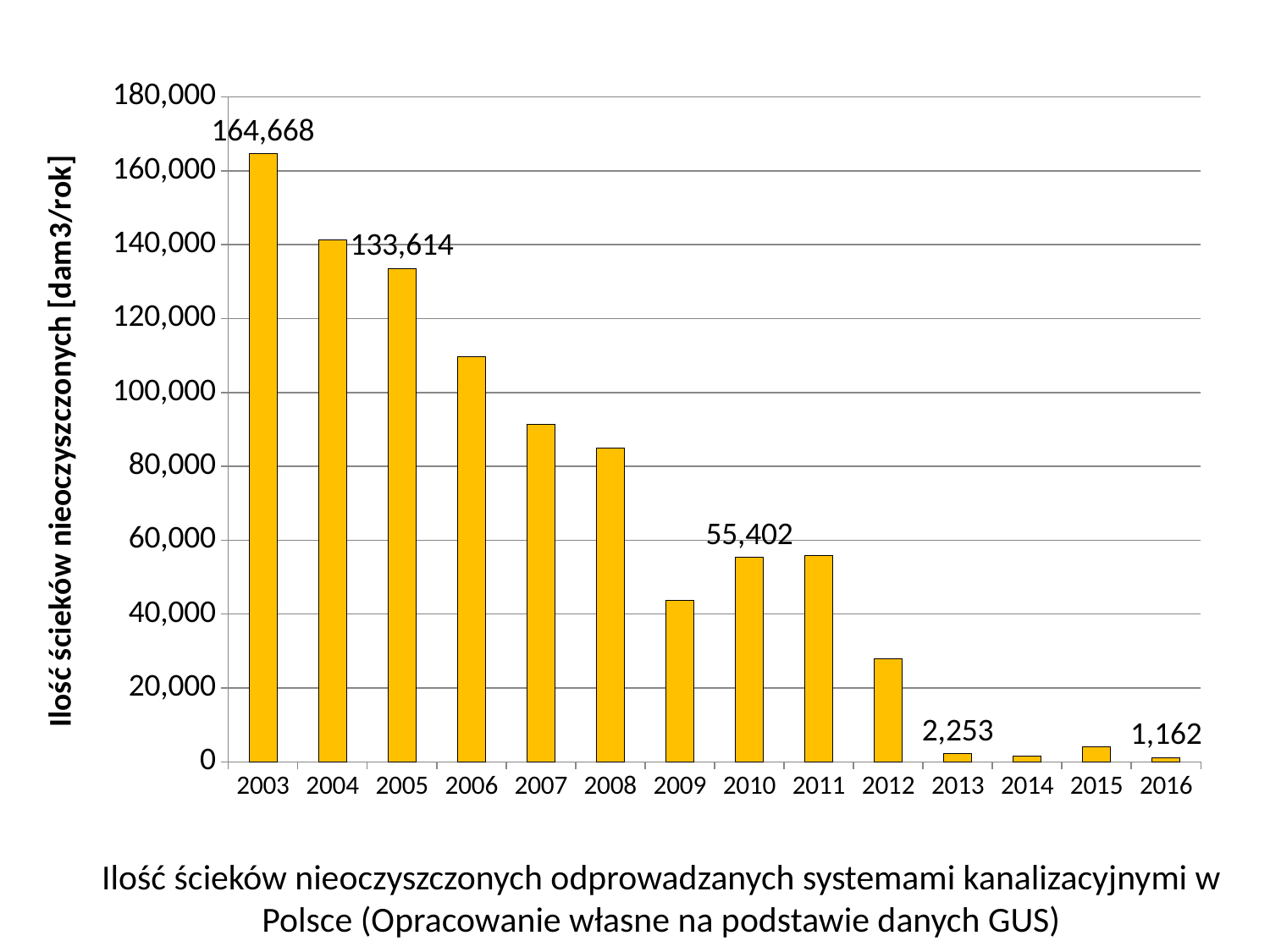
Is the value for 2006 greater or less than 100,000? greater What is the value for 2016? 1,162 What is the difference between the values for 2003 and 2005? 31,054 What is the difference between the values for 2013 and 2016? 1,091 How many years (bars) are shown on the x axis? 14 What is the value for 2010? 55,402 Which year has the highest value? 2003 What type of chart is shown on the slide? Bar chart Is the value for 2012 greater or less than 40,000? less What is the value for 2003? 164,668 What is the value for 2005? 133,614 Do the values generally rise or fall from 2003 to 2016? Fall